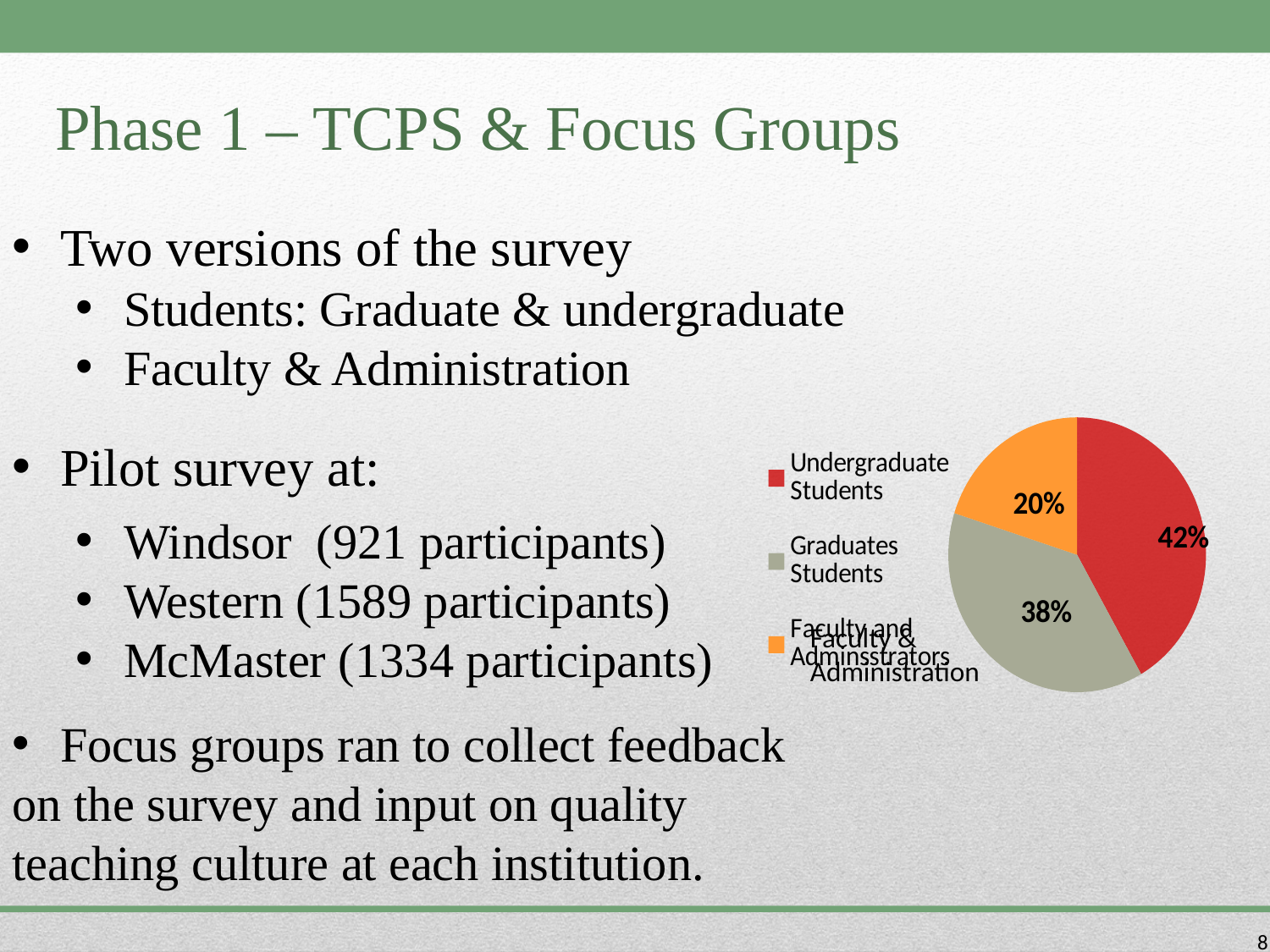
What kind of chart is shown on the slide? pie chart What share of the pie chart is Graduates Students? 38% What share of the pie chart is the orange Faculty and Administrators slice? 20% Which slice of the pie chart is the smallest? Faculty and Administrators What colour is the Undergraduate Students slice in the pie chart? red Which is larger in the pie chart, Graduates Students or Faculty and Administrators? Graduates Students What is the difference in percentage points between the Graduates Students slice and the Faculty and Administrators slice? 18 How many slices does the pie chart have? 3 How many entries does the pie chart legend list? 3 What is the difference in percentage points between the Undergraduate Students slice and the Graduates Students slice? 4 What share of the pie chart is Undergraduate Students? 42% Which slice of the pie chart is the largest? Undergraduate Students